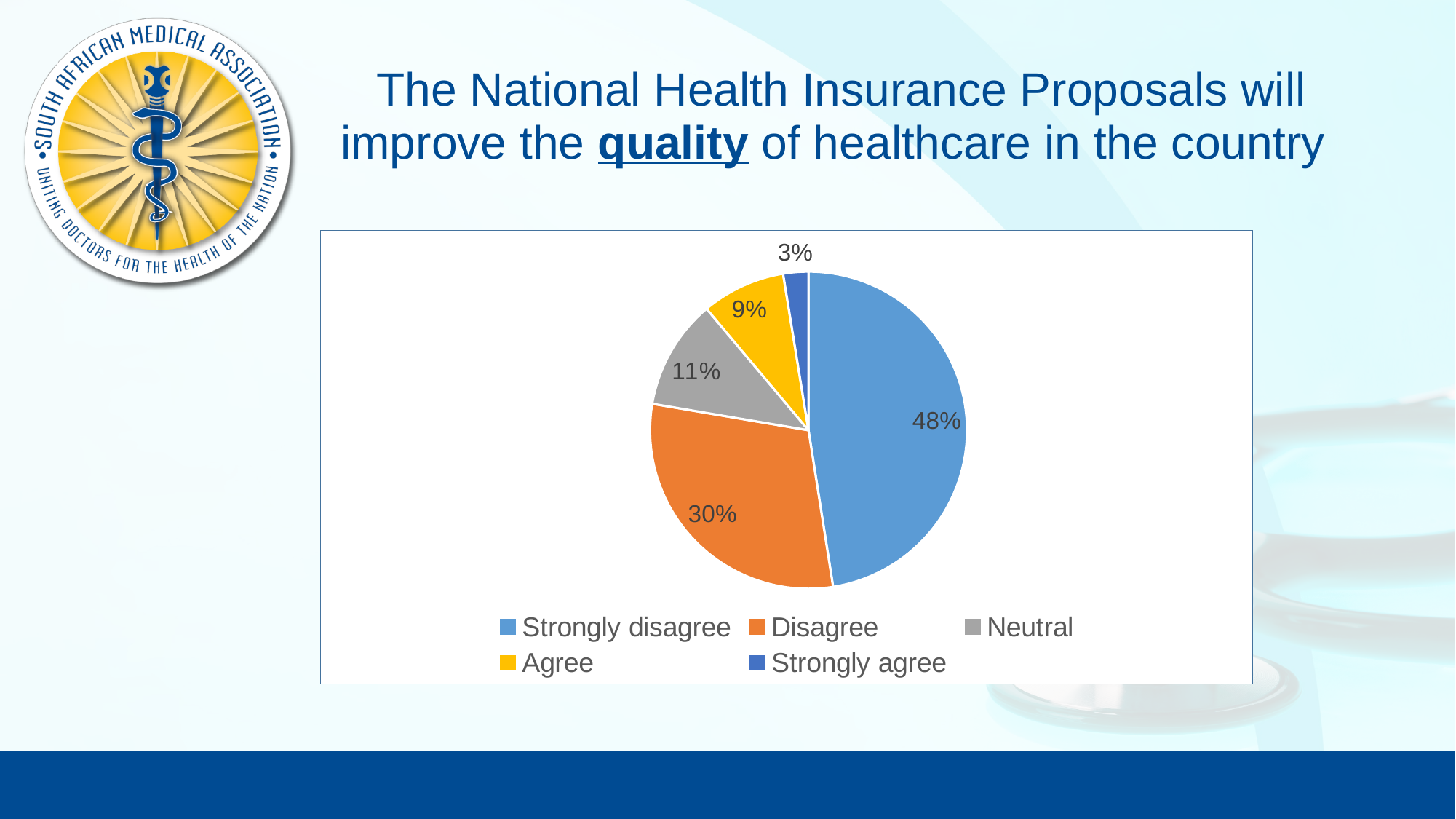
Which is larger, the share for Neutral or the share for Agree? Neutral How many response categories does the legend list? 5 Which response category has the smallest share of the pie? Strongly agree What percentage of respondents chose Disagree? 30% What percentage of respondents chose Strongly agree? 3% What percentage of respondents chose Strongly disagree? 48% Which response category has the largest share of the pie? Strongly disagree What is the difference in percentage points between Strongly disagree and Disagree? 18 What percentage of respondents chose Agree? 9% What colour is the slice for Agree? Yellow What kind of chart is shown on the slide? Pie chart What percentage of respondents chose Neutral? 11%